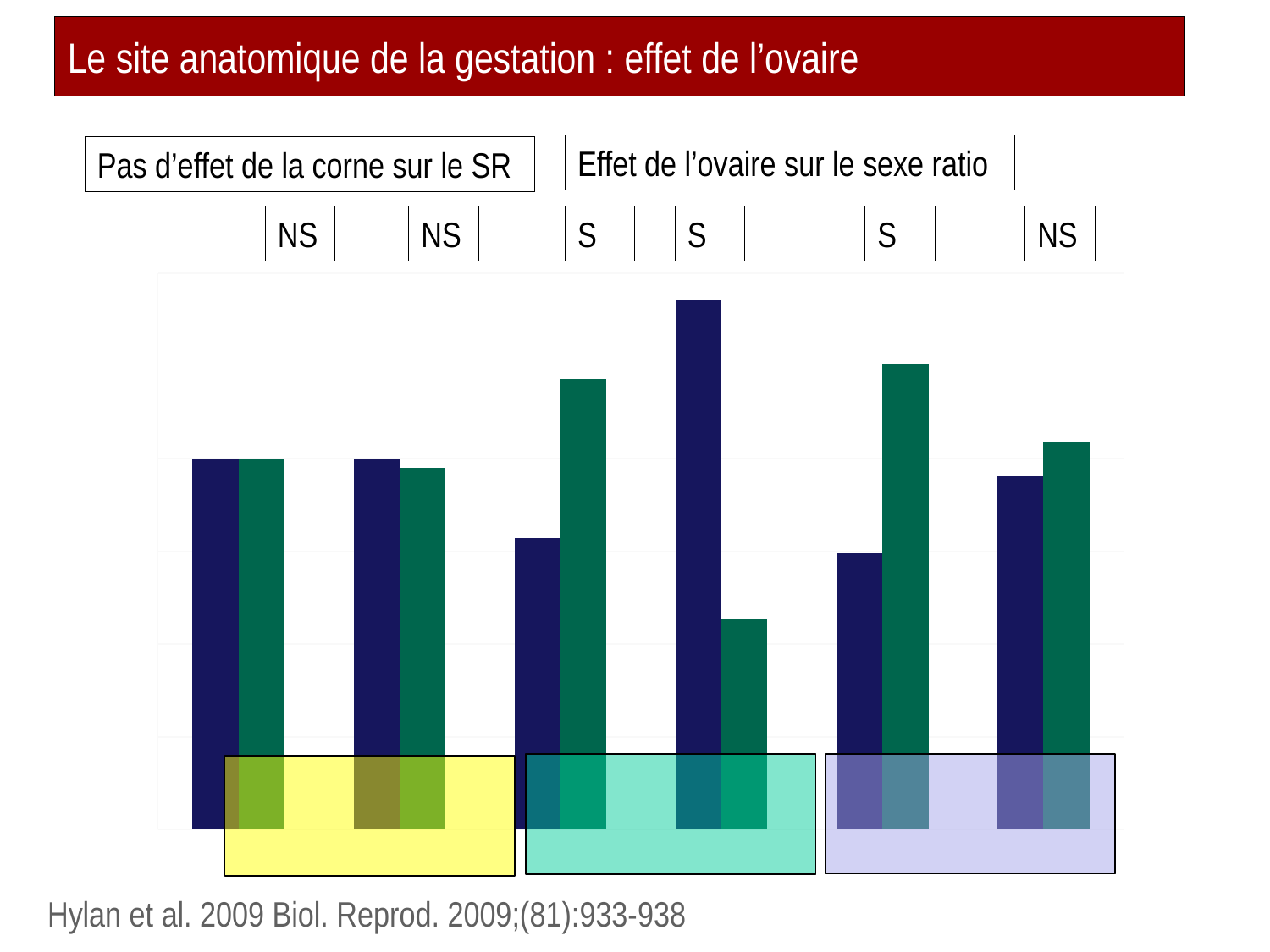
In the fifth group of bars from the left, which bar is taller, the dark blue one or the green one? green How many groups of bars are marked 'NS' above the chart? 3 What kind of chart is shown on the slide? bar chart How many differently coloured bars appear in each group of the chart? 2 In the third group of bars from the left, which bar is taller, the dark blue one or the green one? green Which group of bars, counted from the left, contains the tallest bar in the chart? fourth Which group of bars, counted from the left, contains the shortest bar in the chart? fourth In the fourth group of bars from the left, which bar is taller, the dark blue one or the green one? dark blue How many groups of bars are plotted in the chart? 6 How many groups of bars are marked 'S' above the chart? 3 What is the title of the slide containing the chart? Le site anatomique de la gestation : effet de l'ovaire